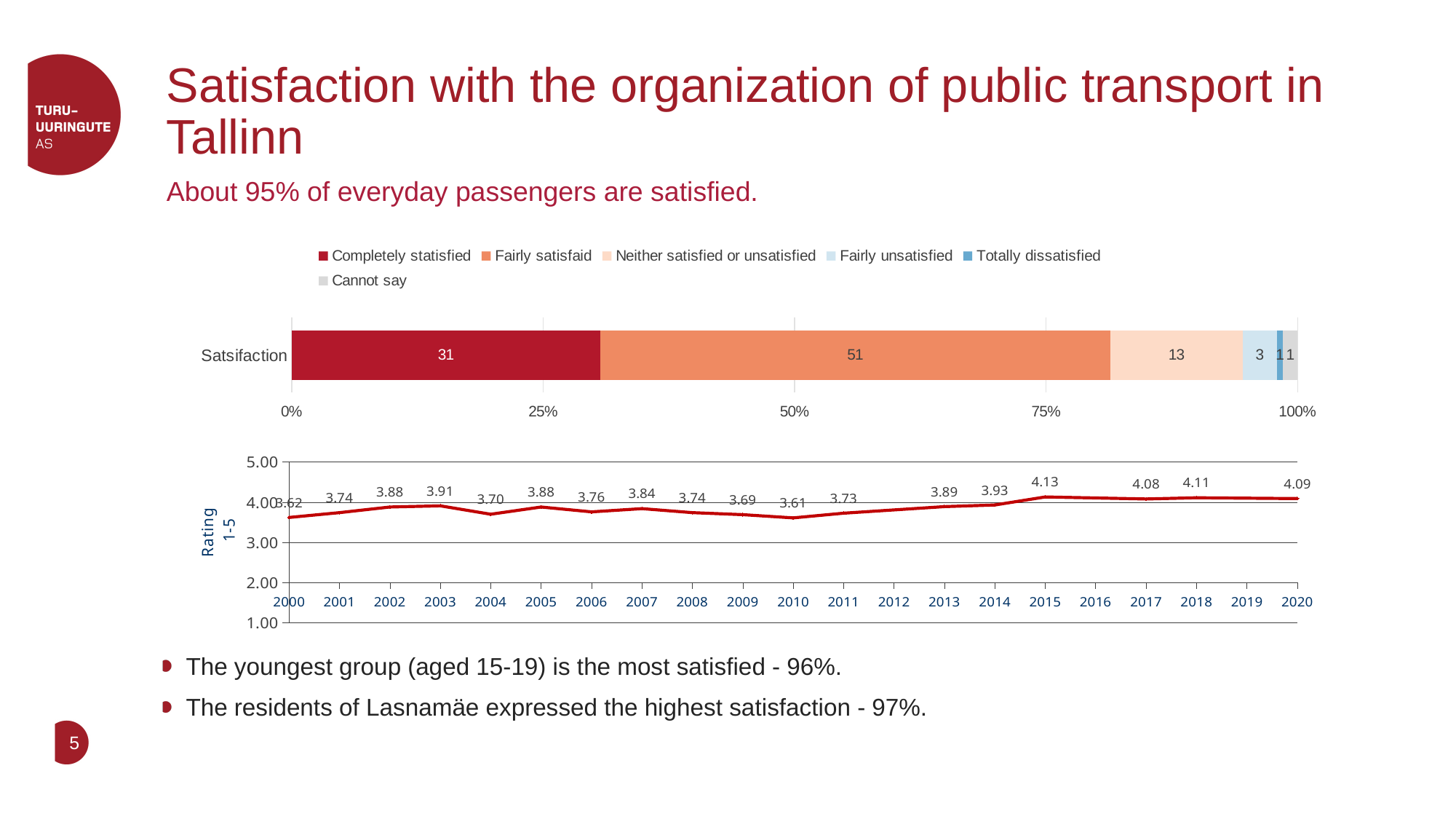
In the bottom line chart, what is the rating for 2000? 3.62 In the top stacked bar chart, what is the value for 'Fairly satisfaid'? 51 What kind of chart is the bottom chart showing ratings from 2000 to 2020? line chart In the top stacked bar chart, what is the value for 'Neither satisfied or unsatisfied'? 13 In the bottom line chart, how many years are shown on the x axis? 21 In the bottom line chart, which year has the highest rating? 2015 In the top stacked bar chart, which segment is the largest? Fairly satisfaid In the bottom line chart, what is the rating for 2015? 4.13 In the bottom line chart, which year has the lowest rating? 2010 In the top stacked bar chart, what is the difference between the 'Fairly satisfaid' and 'Completely statisfied' values? 20 In the top stacked bar chart, what percentage of respondents are 'Completely statisfied'? 31 In the top stacked bar chart, how many series does the legend list? 6